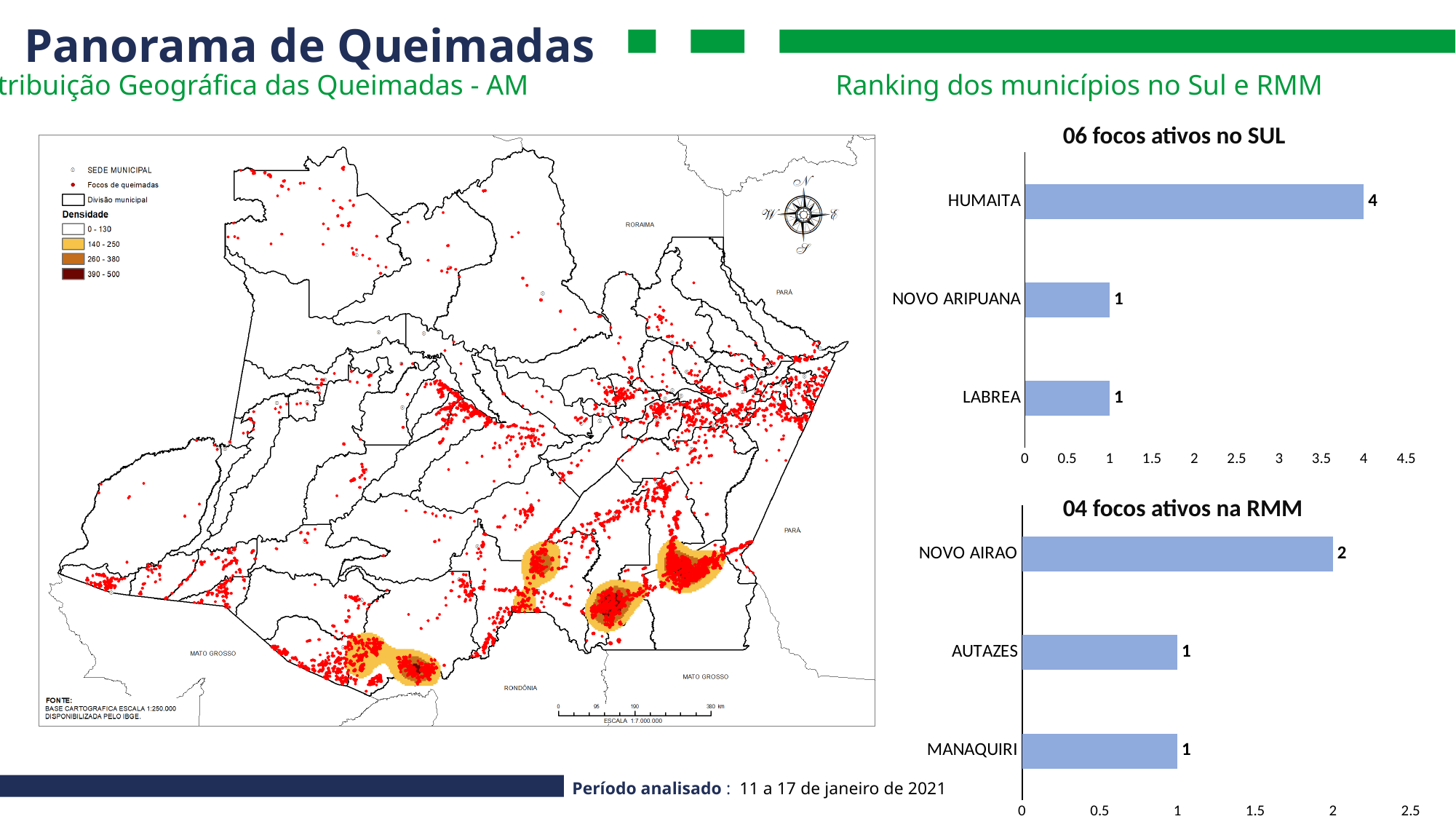
In the chart titled '04 focos ativos na RMM', what is the difference between NOVO AIRAO and AUTAZES? 1 In the chart titled '06 focos ativos no SUL', is the value for HUMAITA greater or less than 3? greater In the chart titled '04 focos ativos na RMM', which is larger, NOVO AIRAO or AUTAZES? NOVO AIRAO In the chart titled '06 focos ativos no SUL', which municipality has the highest value? HUMAITA In the chart titled '06 focos ativos no SUL', what is the difference between HUMAITA and LABREA? 3 In the chart titled '04 focos ativos na RMM', what is the value for NOVO AIRAO? 2 In the chart titled '06 focos ativos no SUL', what is the value for HUMAITA? 4 In the chart titled '06 focos ativos no SUL', what is the value for NOVO ARIPUANA? 1 What kind of chart is the one titled '04 focos ativos na RMM'? Bar chart In the chart titled '04 focos ativos na RMM', which municipality has the highest value? NOVO AIRAO In the chart titled '04 focos ativos na RMM', what is the value for MANAQUIRI? 1 In the chart titled '06 focos ativos no SUL', how many municipalities are shown? 3